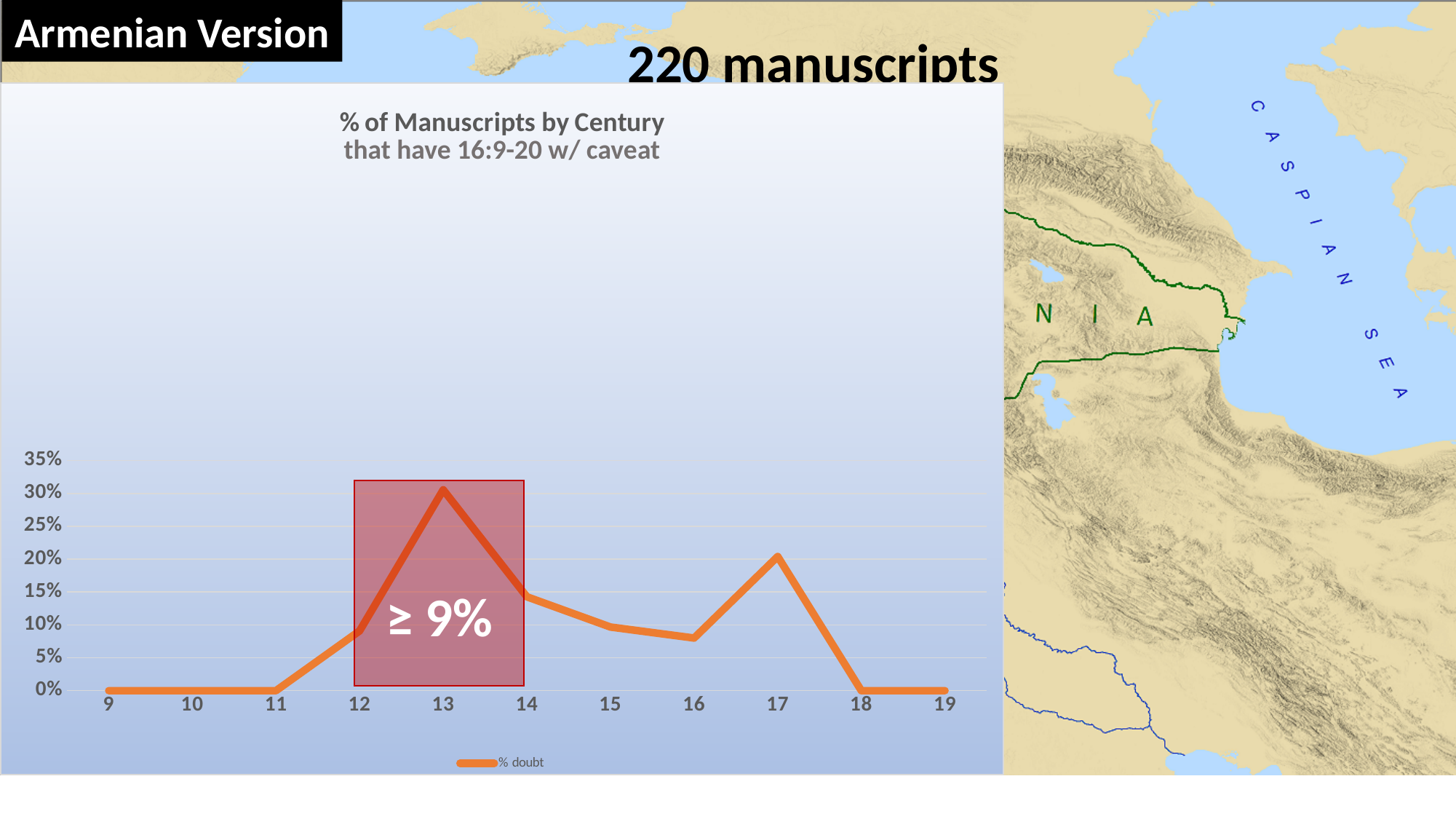
What kind of chart is shown on the slide? line chart Do the % doubt values rise or fall from century 13 to century 16? fall Is the % doubt value for century 17 greater or less than 15%? greater Which century has the larger % doubt value, 13 or 17? 13 What is the % doubt value for century 9? 0% What is the % doubt value for century 18? 0% What is the name of the series shown in the chart's legend? % doubt Which century has the highest % doubt value in the chart? 13 Is the % doubt value for century 13 greater or less than 25%? greater Is the % doubt value for century 16 greater or less than 10%? less How many centuries are plotted along the x axis of the chart? 11 How many series does the chart's legend list? 1